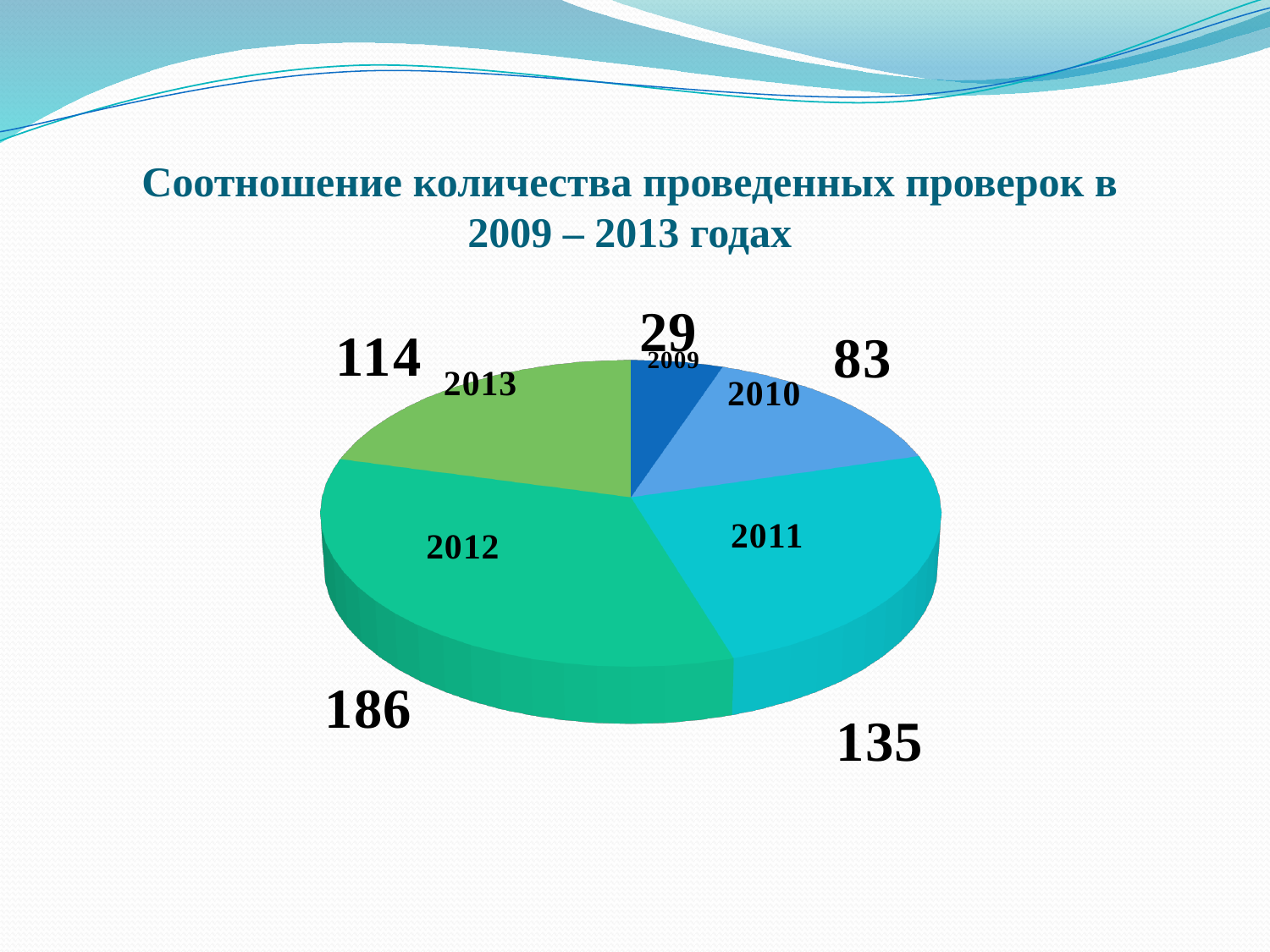
What is the difference between the values for 2012 and 2011? 51 How many slices does the pie chart have? 5 What is the title of the chart on the slide? Соотношение количества проведенных проверок в 2009 – 2013 годах What is the difference between the values for 2013 and 2010? 31 What value is shown for 2009 in the pie chart? 29 Which year has the smallest slice in the pie chart? 2009 Which year has the largest slice in the pie chart? 2012 Which is larger, the value for 2010 or the value for 2013? 2013 What is the total of all the values shown in the pie chart? 547 What value is shown for 2011 in the pie chart? 135 What kind of chart is shown on the slide? Pie chart What value is shown for 2012 in the pie chart? 186